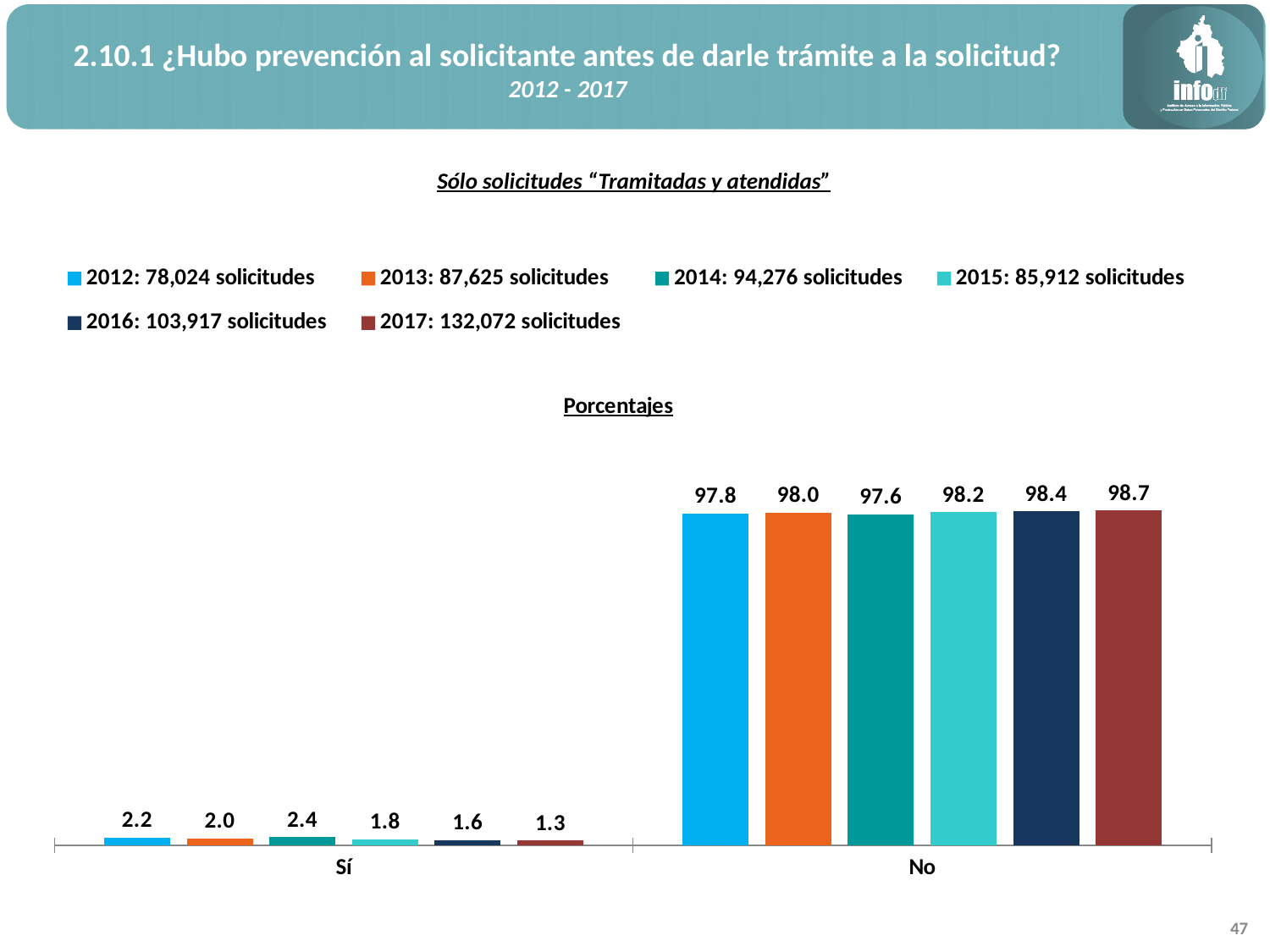
What is the value for 2012 in the "No" category? 97.8 Which year has the lowest value in the "No" category? 2014 What is the value for 2014 in the "Sí" category? 2.4 What is the value for 2017 in the "No" category? 98.7 Which is larger: the 2015 value for "No" or the 2013 value for "No"? 2015 According to the legend, how many solicitudes were there in 2017? 132,072 Do the values in the "Sí" category rise or fall from 2015 to 2017? Fall What is the difference between the 2012 and 2017 values in the "Sí" category? 0.9 How many series does the legend list? 6 How many categories are shown on the x axis? 2 Which year has the highest value in the "Sí" category? 2014 What kind of chart is shown on the slide? Bar chart